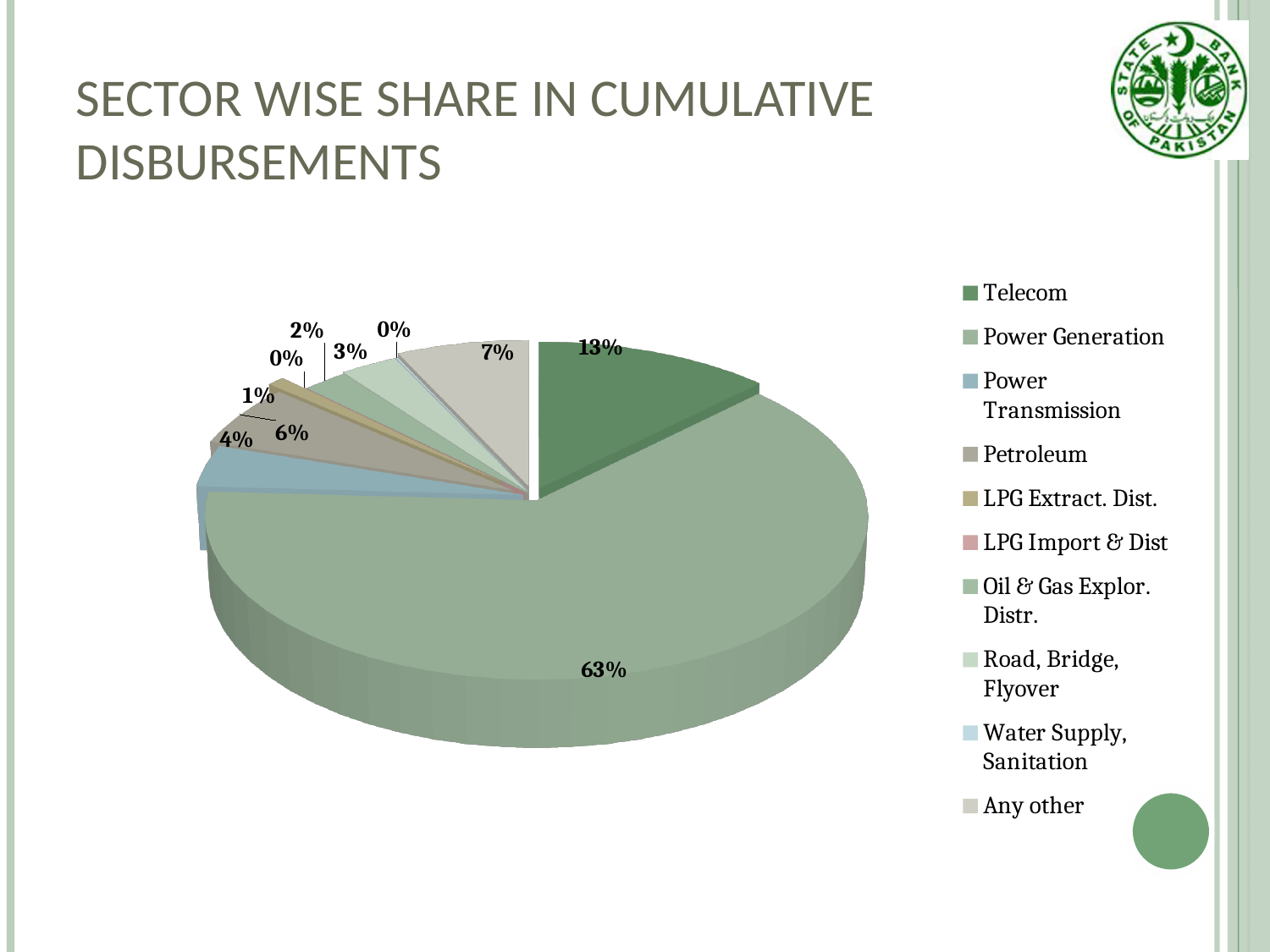
What share of cumulative disbursements does Telecom have? 13% What share of cumulative disbursements does Petroleum have? 6% What share of cumulative disbursements does Power Transmission have? 4% Which has a larger share, Petroleum or Power Transmission? Petroleum How many sectors does the legend list? 10 What is the title of the chart on the slide? SECTOR WISE SHARE IN CUMULATIVE DISBURSEMENTS Which sector has the largest share of cumulative disbursements? Power Generation What kind of chart is shown on the slide? pie chart Which has a larger share, Telecom or Any other? Telecom What is the difference in share between Power Generation and Telecom? 50%